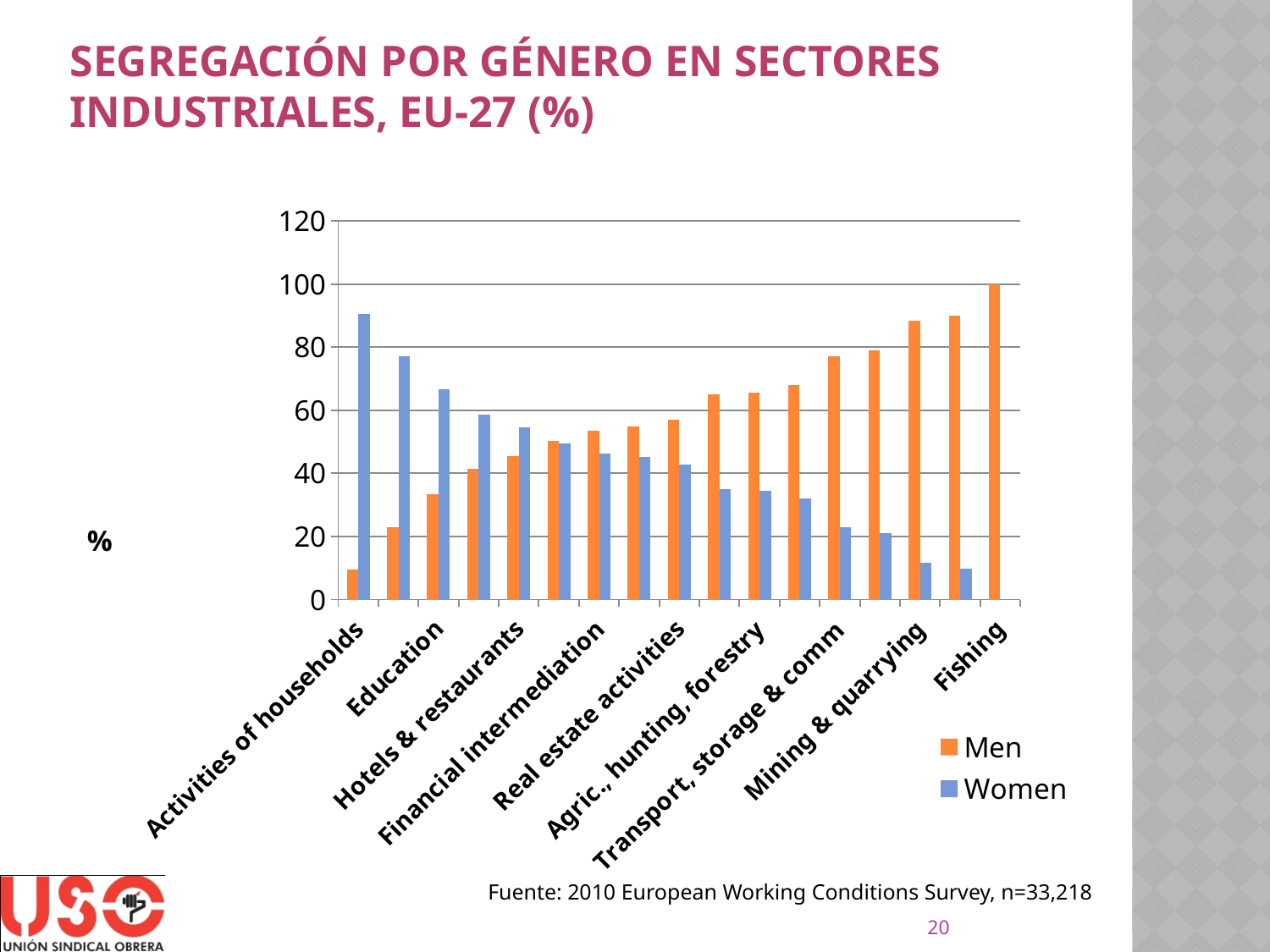
For Education, which is larger, the Men value or the Women value? Women For Mining & quarrying, which is larger, the Men value or the Women value? Men Is the Women value for Mining & quarrying greater or less than 20? less Which colour represents the Men series? orange Do the Men values rise or fall moving from left to right along the x axis? rise Which labelled sector has the highest Men value? Fishing Is the Women value for Activities of households greater or less than 80? greater Is the Men value for Fishing greater or less than 80? greater What are the two series named in the legend? Men and Women What kind of chart is shown on the slide? bar chart How many series does the legend list? 2